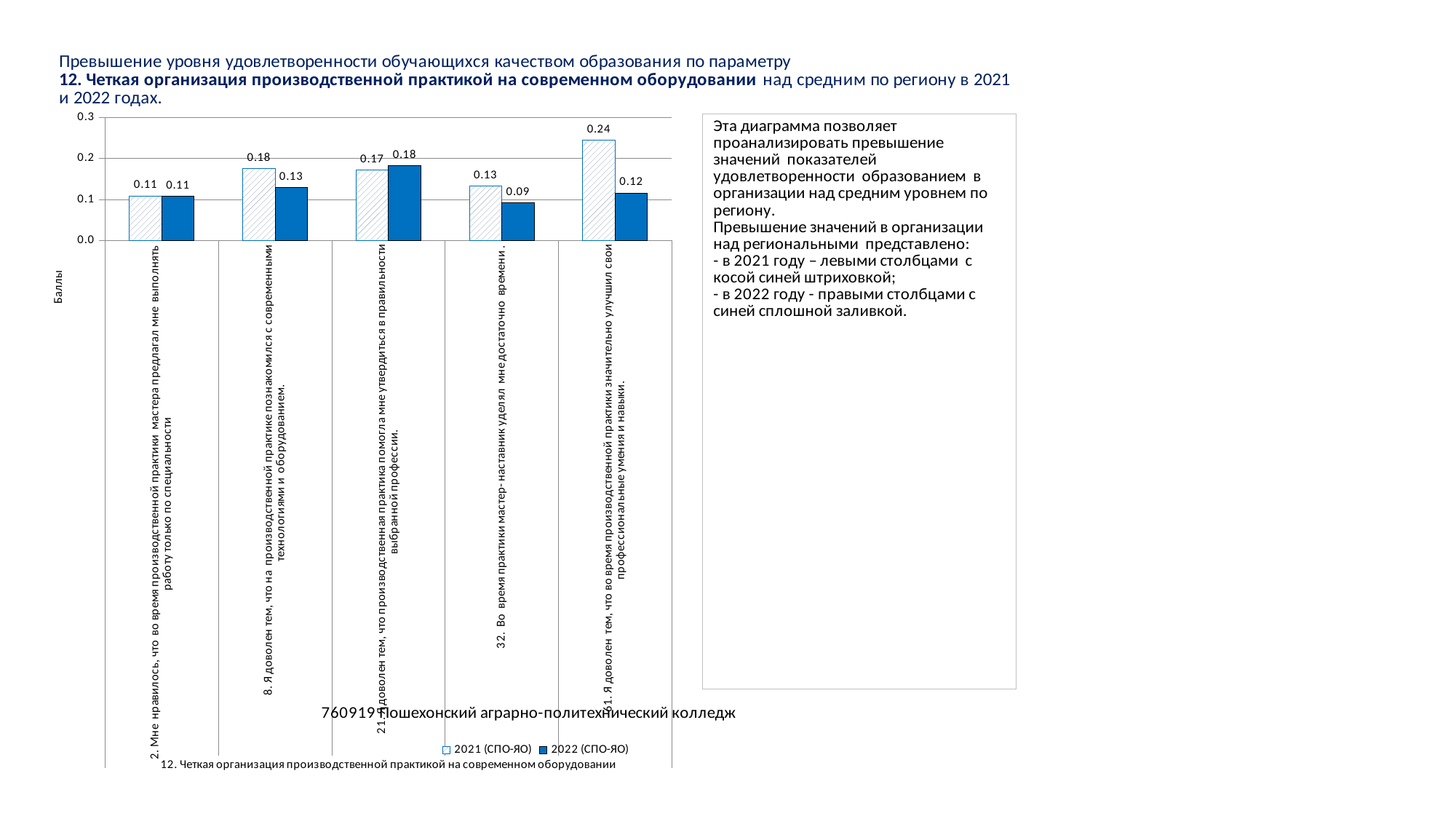
What are the two series names in the chart legend? 2021 (СПО-ЯО) and 2022 (СПО-ЯО) What is the difference between the 2021 and 2022 values for statement 51? 0.12 How many statements (categories) are shown on the x axis of the chart? 5 For statement 21 ("производственная практика помогла мне утвердиться в правильности выбранной профессии"), which is larger: the 2021 value or the 2022 value? 2022 (0.18) Is the 2021 (СПО-ЯО) value for statement 51 greater or less than 0.2? greater What type of chart is shown on the slide? Bar chart What is the 2021 (СПО-ЯО) value for statement 51 ("Я доволен тем, что во время производственной практики значительно улучшил свои профессиональные умения и навыки")? 0.24 Which statement has the highest 2021 (СПО-ЯО) value? 51. Я доволен тем, что во время производственной практики значительно улучшил свои профессиональные умения и навыки Which statement has the lowest 2022 (СПО-ЯО) value? 32. Во время практики мастер-наставник уделял мне достаточно времени What is the 2022 (СПО-ЯО) value for statement 32 ("Во время практики мастер-наставник уделял мне достаточно времени")? 0.09 What is the 2022 (СПО-ЯО) value for statement 8 ("Я доволен тем, что на производственной практике познакомился с современными технологиями и оборудованием")? 0.13 How many series does the chart legend list? 2